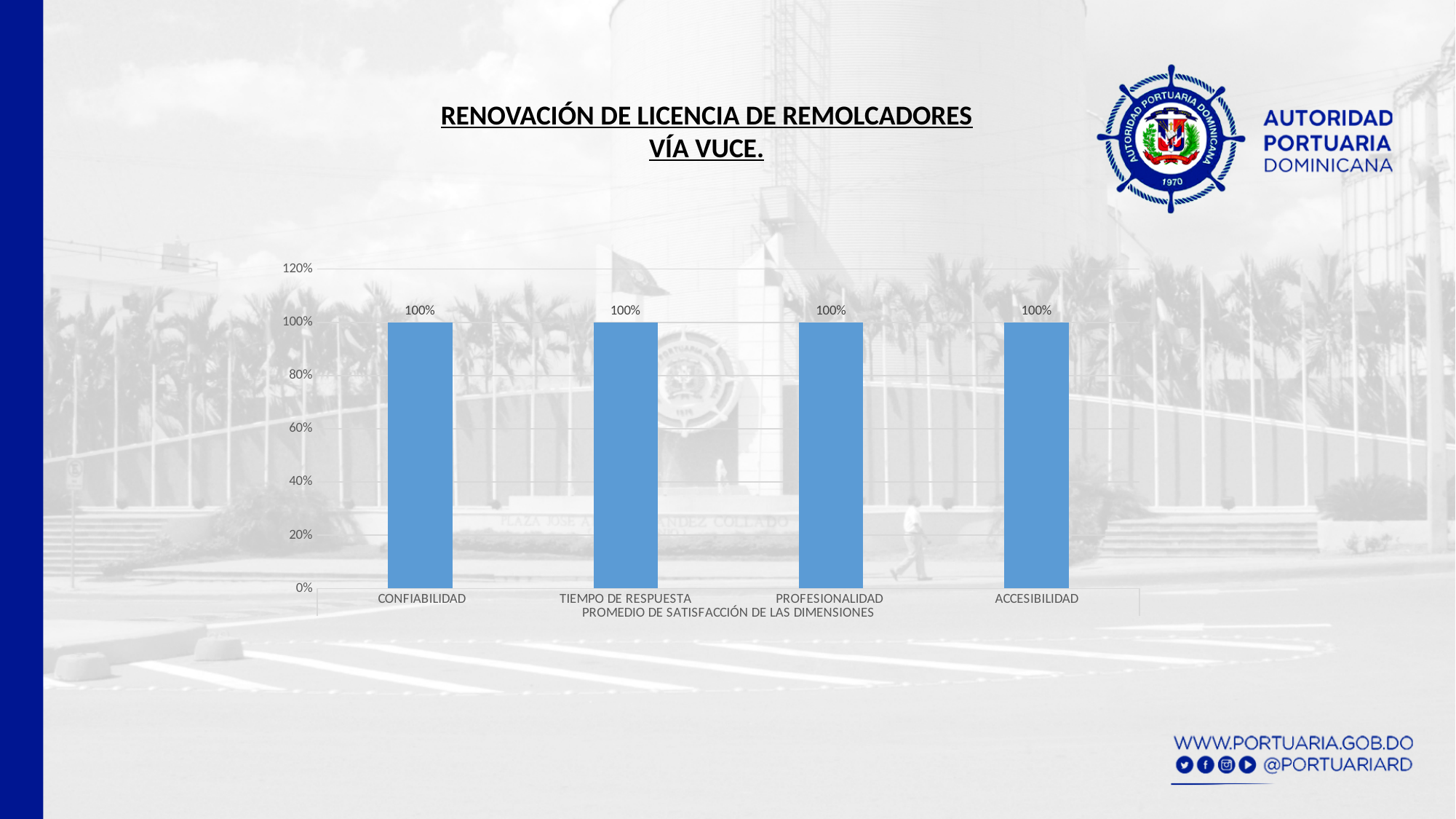
Is the value for PROFESIONALIDAD greater or less than 80%? greater What is the value for TIEMPO DE RESPUESTA? 100% What is the value for CONFIABILIDAD? 100% How many categories are shown on the chart? 4 What is the highest value shown on the vertical axis? 120% What is the difference between the values for CONFIABILIDAD and ACCESIBILIDAD? 0% Is the value for TIEMPO DE RESPUESTA greater or less than 120%? less What is the value for ACCESIBILIDAD? 100% What is the value for PROFESIONALIDAD? 100% What kind of chart is shown on the slide? bar chart What is the label shown beneath the category names on the horizontal axis? PROMEDIO DE SATISFACCIÓN DE LAS DIMENSIONES Do the values rise, fall or stay the same across the categories from left to right? stay the same